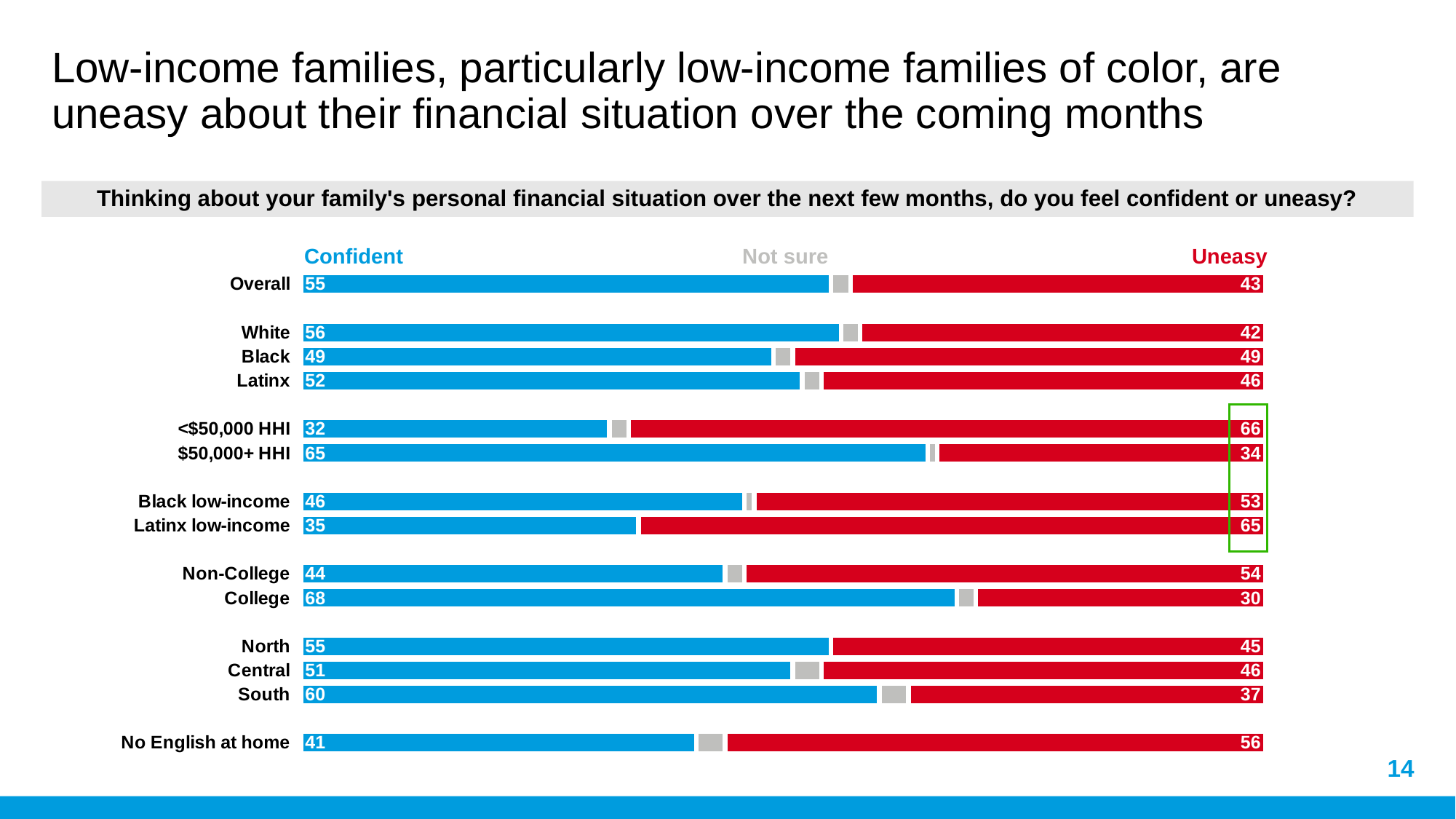
What type of chart is shown on the slide? Stacked bar chart What is the difference between the Uneasy values for <$50,000 HHI and $50,000+ HHI? 32 How many categories are shown in the chart? 14 How many series does the chart show? 3 Which has a larger Confident value, North or South? South What is the Uneasy value for No English at home? 56 What is the Confident value for $50,000+ HHI? 65 Which category has the highest Uneasy value? <$50,000 HHI Which category has the highest Confident value? College What is the Confident value for Overall? 55 What is the Uneasy value for Latinx low-income? 65 Which category has the lowest Uneasy value? College